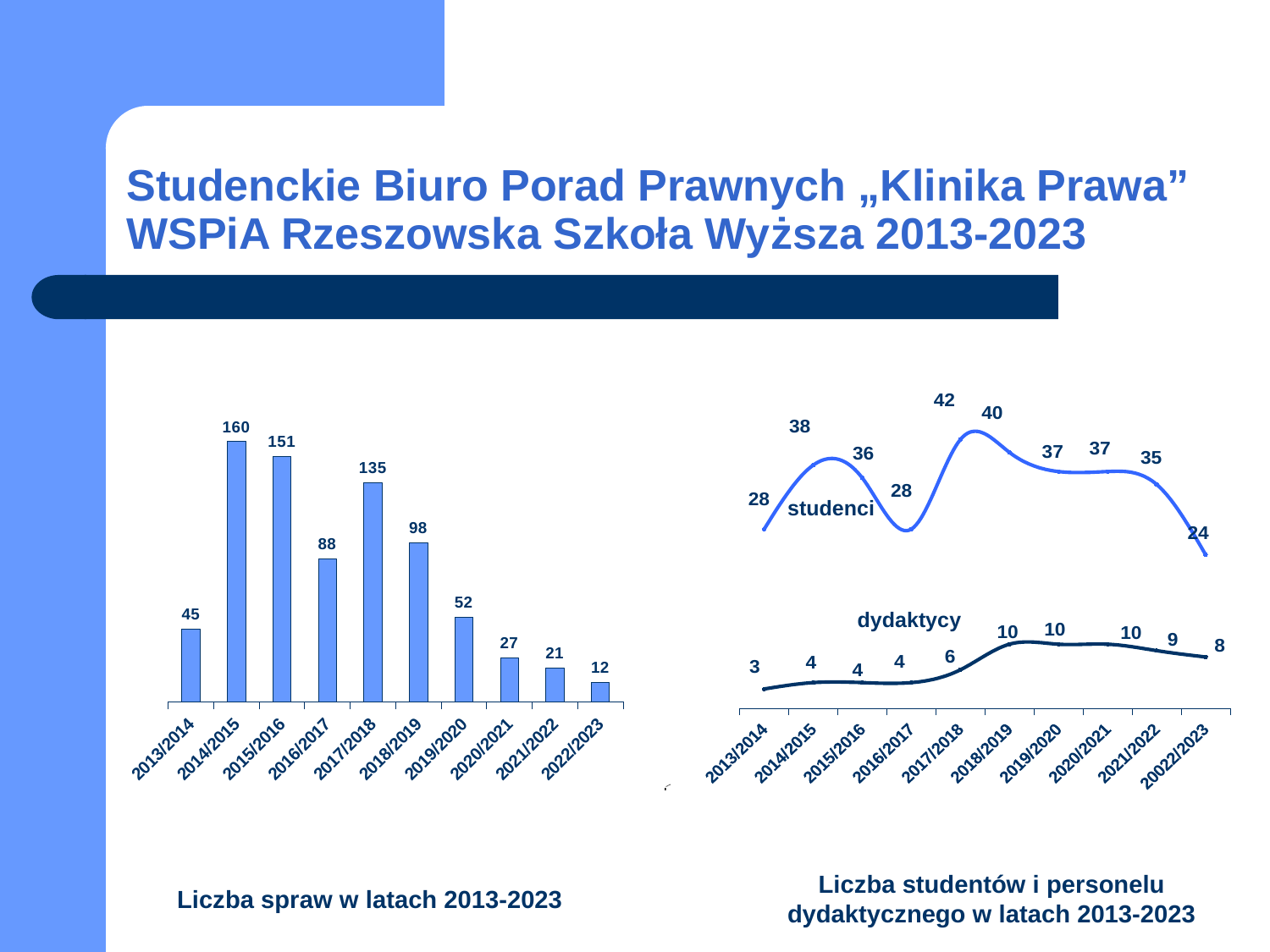
In the chart titled "Liczba spraw w latach 2013-2023", which is larger: the value for 2016/2017 or the value for 2018/2019? 2018/2019 In the chart titled "Liczba studentów i personelu dydaktycznego w latach 2013-2023", what is the value of the dydaktycy series for 2013/2014? 3 In the chart titled "Liczba studentów i personelu dydaktycznego w latach 2013-2023", what is the value of the studenci series for 2017/2018? 42 In the chart titled "Liczba spraw w latach 2013-2023", what is the value for 2017/2018? 135 In the chart titled "Liczba studentów i personelu dydaktycznego w latach 2013-2023", what is the difference between the studenci and dydaktycy values for 2018/2019? 30 In the chart titled "Liczba spraw w latach 2013-2023", what is the difference between the values for 2014/2015 and 2015/2016? 9 In the chart titled "Liczba spraw w latach 2013-2023", which year has the lowest value? 2022/2023 In the chart titled "Liczba spraw w latach 2013-2023", how many years are shown on the x axis? 10 In the chart titled "Liczba spraw w latach 2013-2023", do the values rise or fall from 2018/2019 to 2022/2023? fall In the chart titled "Liczba spraw w latach 2013-2023", which year has the highest value? 2014/2015 How many series are plotted in the chart titled "Liczba studentów i personelu dydaktycznego w latach 2013-2023"? 2 What kind of chart is the one titled "Liczba spraw w latach 2013-2023"? bar chart